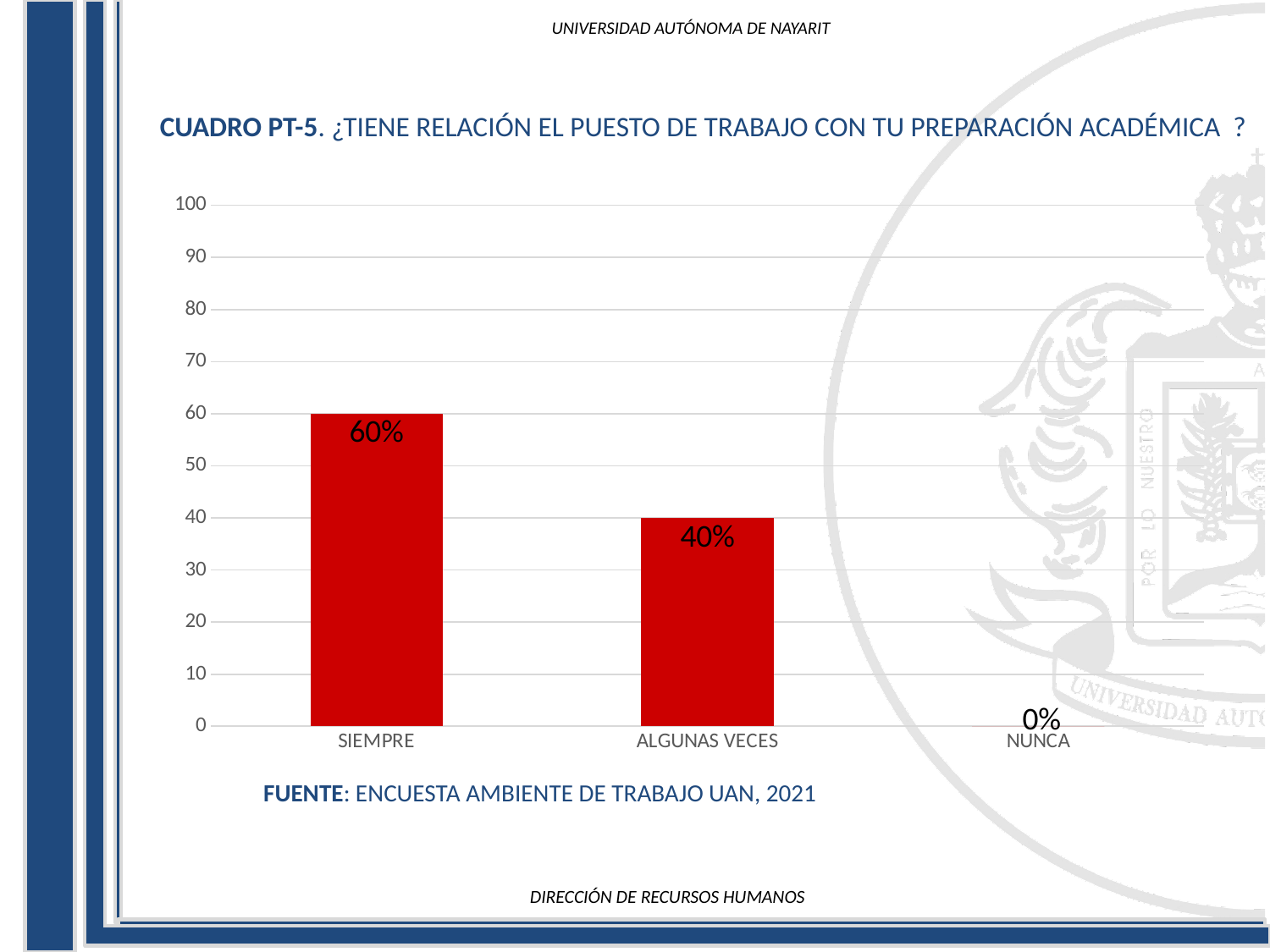
What is the value for ALGUNAS VECES? 40% What source is cited below the chart? ENCUESTA AMBIENTE DE TRABAJO UAN, 2021 Which is larger, the value for SIEMPRE or the value for ALGUNAS VECES? SIEMPRE What is the value for SIEMPRE? 60% What kind of chart is shown on the slide? bar chart What is the difference between the values for SIEMPRE and ALGUNAS VECES? 20% Do the values rise or fall from left to right along the x axis? fall Which category has the highest value? SIEMPRE What is the value for NUNCA? 0% How many categories are shown on the x axis? 3 Is the value for SIEMPRE greater or less than 50? greater Which category has the lowest value? NUNCA